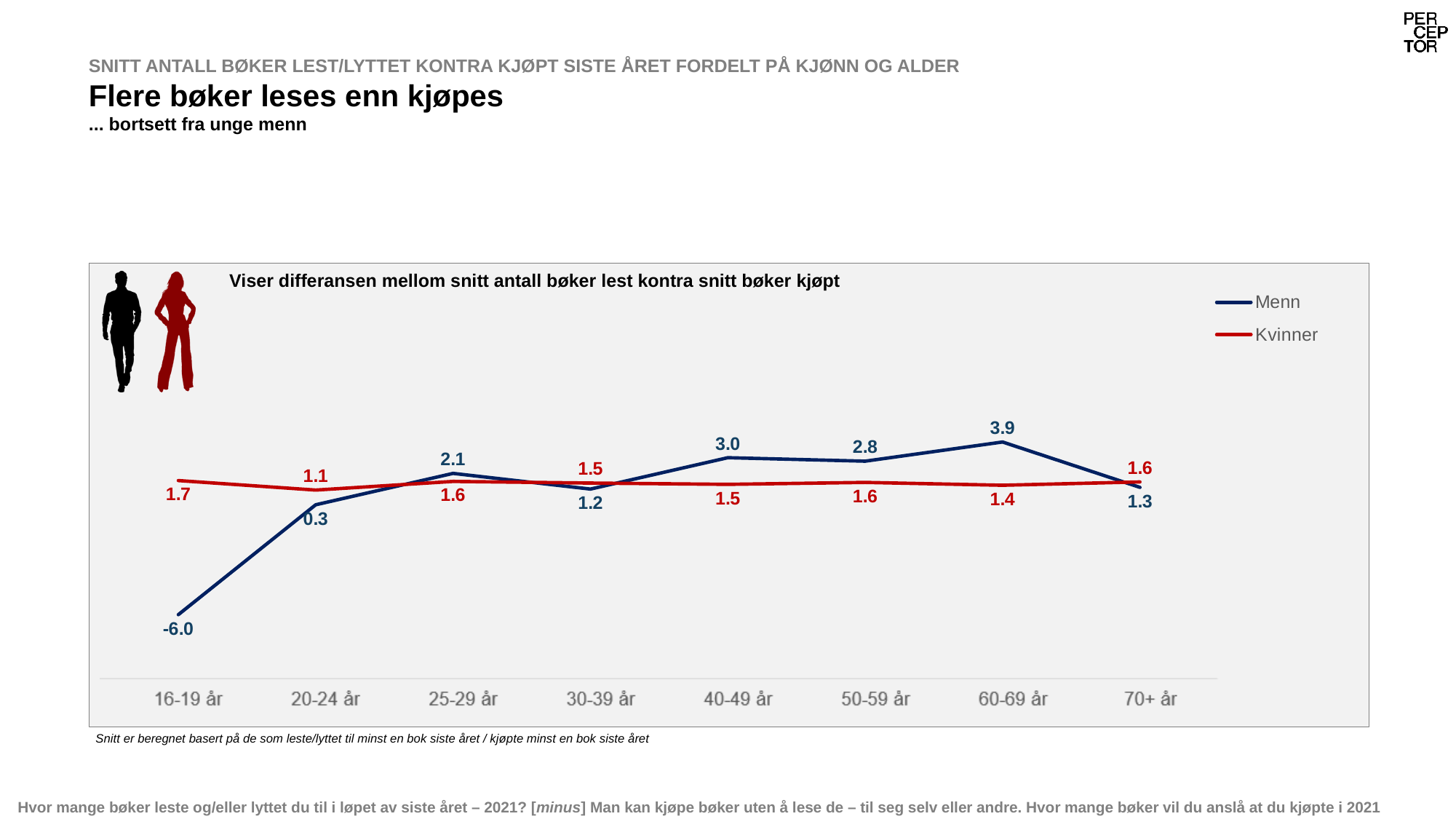
How many series does the legend list? 2 What is the difference between the Menn values for 60-69 år and 70+ år? 2.6 Which age group has the lowest value for Menn? 16-19 år What is the value for Menn in the 16-19 år age group? -6.0 Which age group has the lowest value for Kvinner? 20-24 år What is the value for Menn in the 20-24 år age group? 0.3 What is the value for Kvinner in the 70+ år age group? 1.6 Which age group has the highest value for Menn? 60-69 år In the 40-49 år age group, which series has the larger value, Menn or Kvinner? Menn What kind of chart is shown on the slide? Line chart How many age groups are shown on the x axis? 8 What is the difference between the Kvinner and Menn values in the 16-19 år age group? 7.7